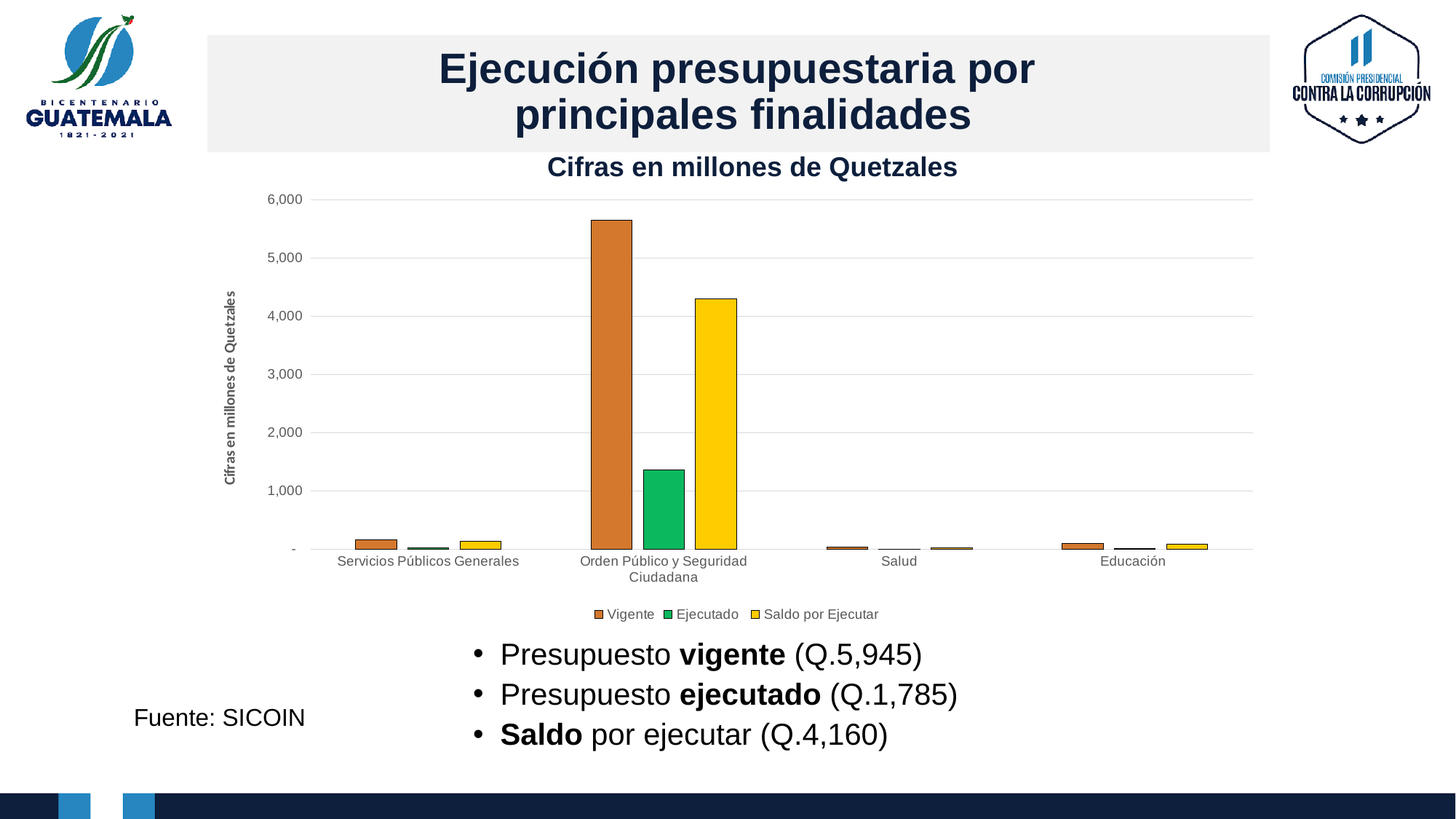
How many categories are shown on the x axis of the chart? 4 Is the Vigente value for Servicios Públicos Generales greater or less than 1,000? less How many series does the chart legend list? 3 Is the Saldo por Ejecutar value for Orden Público y Seguridad Ciudadana greater or less than 4,000? greater What kind of chart is shown on the slide? bar chart Is the Ejecutado value for Orden Público y Seguridad Ciudadana greater or less than 2,000? less For Orden Público y Seguridad Ciudadana, which is larger: the Vigente value or the Ejecutado value? Vigente Which category has the lowest Vigente value? Salud What is the title shown above the chart? Cifras en millones de Quetzales Which category has the highest Vigente value? Orden Público y Seguridad Ciudadana Which series is shown in green in the chart legend? Ejecutado